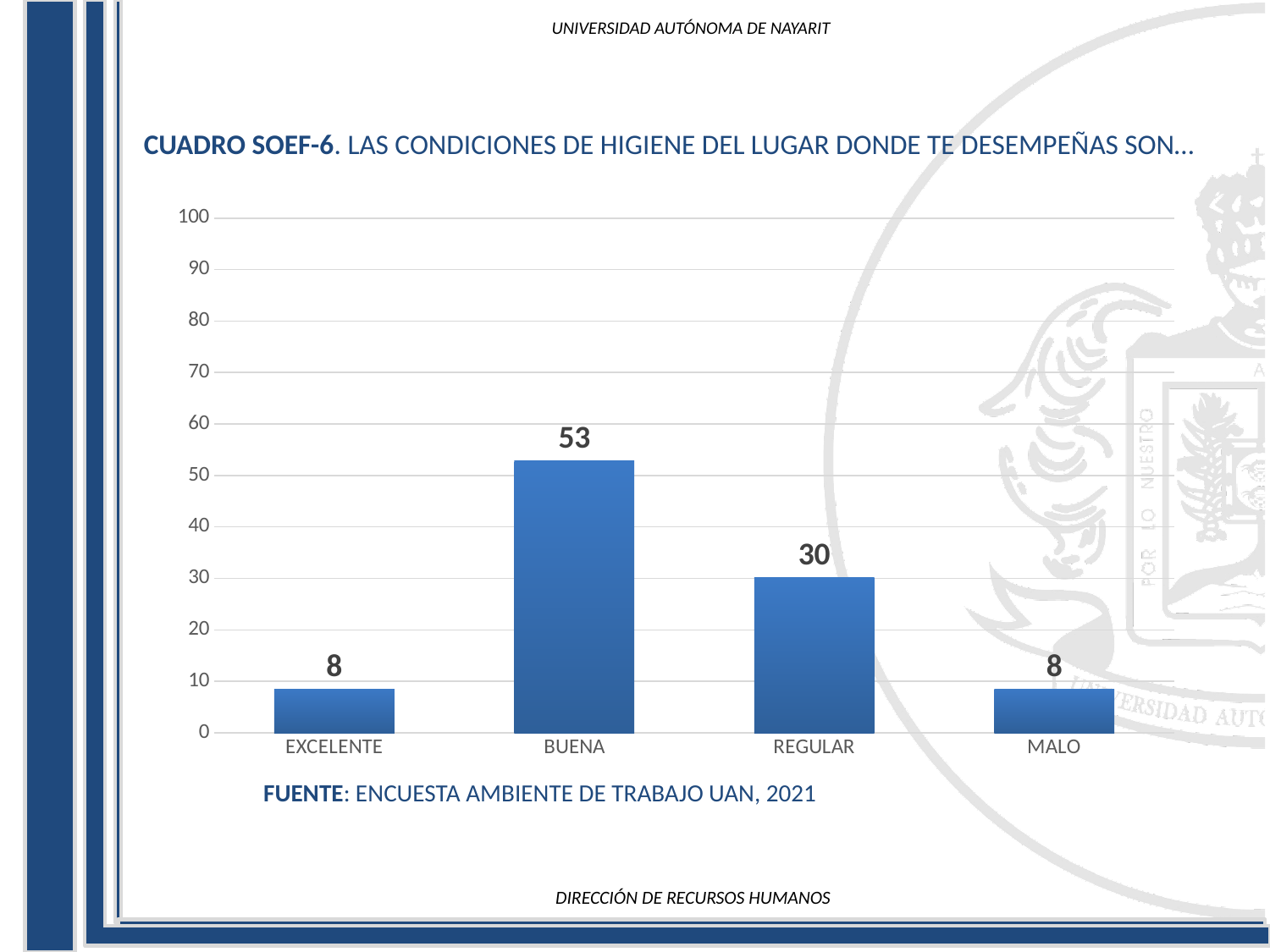
Which category has the highest value? BUENA What is the source cited below the chart? ENCUESTA AMBIENTE DE TRABAJO UAN, 2021 What is the value for MALO? 8 What is the value for EXCELENTE? 8 How many categories are shown on the x axis? 4 What is the value for REGULAR? 30 What is the difference between the values for BUENA and REGULAR? 23 What is the difference between the values for REGULAR and MALO? 22 Is the value for BUENA greater or less than 50? greater Which is larger, the value for BUENA or the value for REGULAR? BUENA What is the value for BUENA? 53 What kind of chart is shown on the slide? bar chart